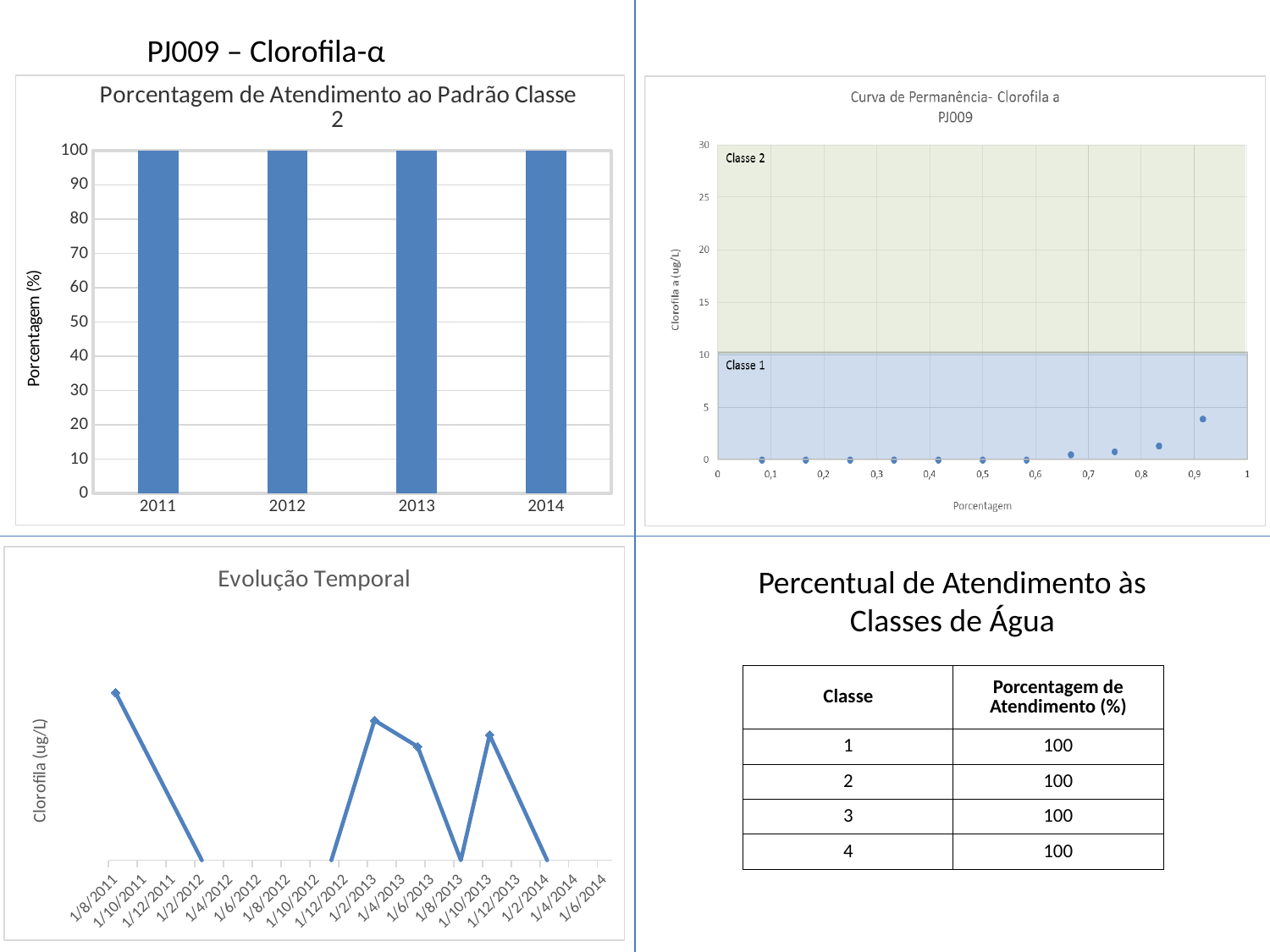
In the chart titled "Porcentagem de Atendimento ao Padrão Classe 2", what is the label of the y axis? Porcentagem (%) In the chart titled "Porcentagem de Atendimento ao Padrão Classe 2", how many years are shown on the x axis? 4 In the chart titled "Evolução Temporal", what is the label of the y axis? Clorofila (ug/L) In the chart titled "Curva de Permanência- Clorofila a PJ009", is the value of the point at about 0.9 on the x axis greater or less than 5? less In the chart titled "Porcentagem de Atendimento ao Padrão Classe 2", what is the value for 2011? 100 What kind of chart is the one titled "Evolução Temporal"? line chart In the chart titled "Curva de Permanência- Clorofila a PJ009", which shaded region is labelled at the top of the plot area? Classe 2 In the chart titled "Curva de Permanência- Clorofila a PJ009", is the value of the point at about 0.5 on the x axis greater or less than 5? less In the chart titled "Porcentagem de Atendimento ao Padrão Classe 2", what is the difference between the values for 2012 and 2013? 0 What kind of chart is the one titled "Porcentagem de Atendimento ao Padrão Classe 2"? bar chart In the chart titled "Porcentagem de Atendimento ao Padrão Classe 2", do the values rise, fall or stay the same from 2011 to 2014? stay the same In the chart titled "Porcentagem de Atendimento ao Padrão Classe 2", what is the value for 2014? 100